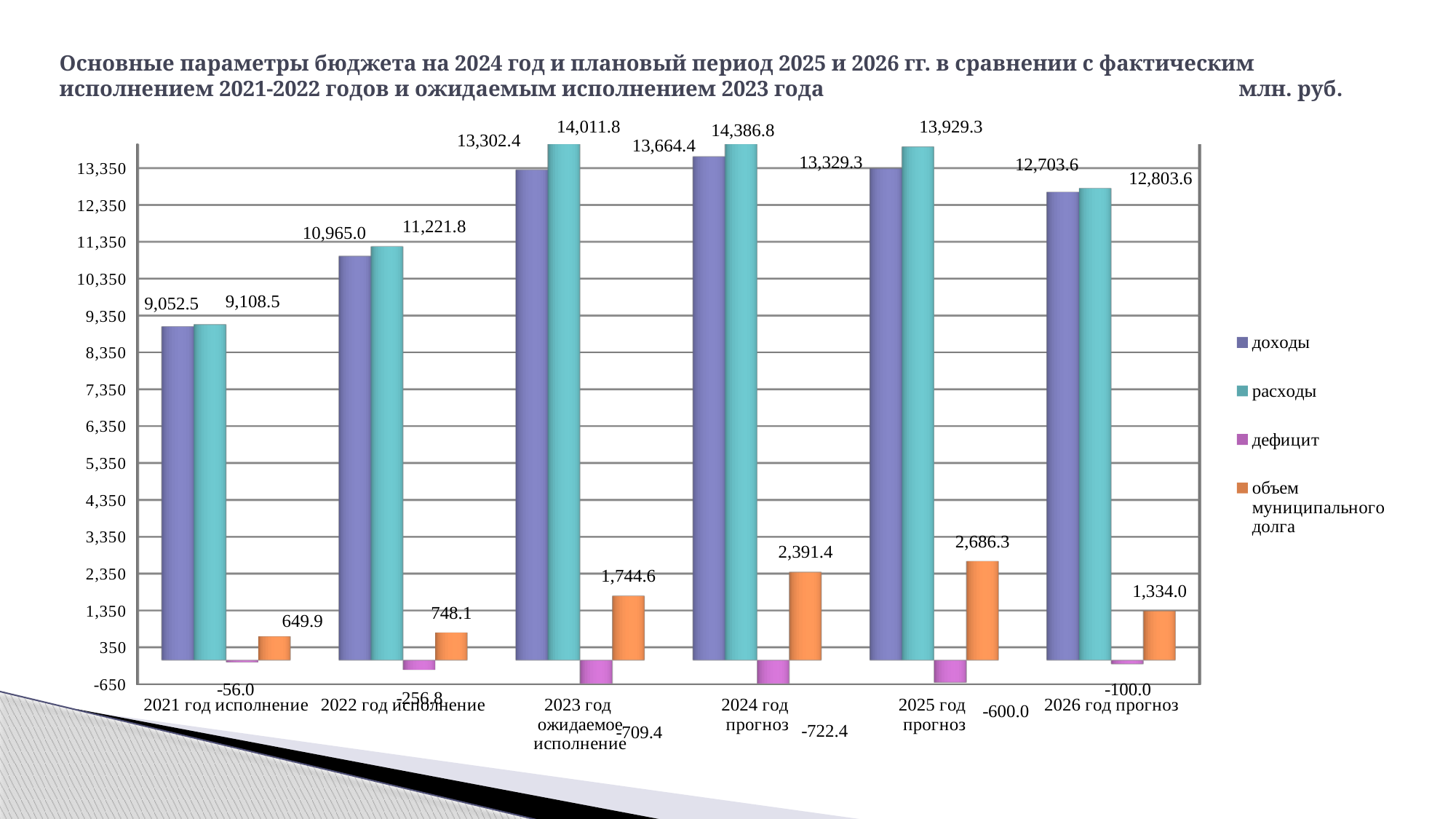
How many series does the legend list? 4 What is the value of объем муниципального долга for 2025 год прогноз? 2,686.3 In which category is расходы the highest? 2024 год прогноз What unit is indicated in the top right of the slide title? млн. руб. What kind of chart is shown on the slide? bar chart What is the difference between расходы and доходы for 2026 год прогноз? 100.0 What is the value of доходы for 2024 год прогноз? 13,664.4 Which is larger: объем муниципального долга for 2024 год прогноз or for 2023 год ожидаемое исполнение? 2024 год прогноз What is the value of расходы for 2022 год исполнение? 11,221.8 What is the value of дефицит for 2023 год ожидаемое исполнение? -709.4 In which category is объем муниципального долга the lowest? 2021 год исполнение How many categories are shown on the x axis? 6